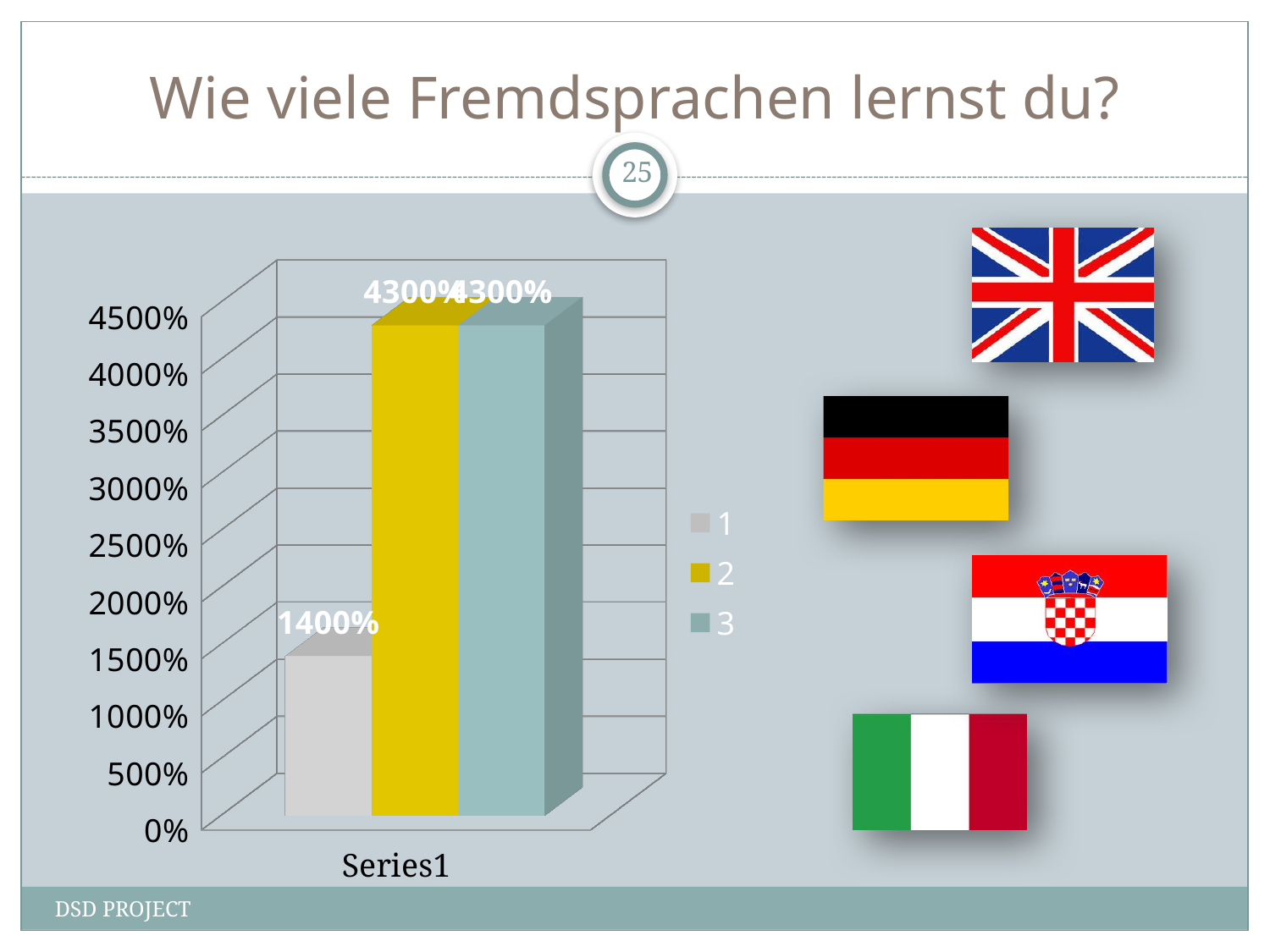
How many categories are shown on the x axis of the chart? 1 What is the value for series 1 in the bar chart? 1400% What is the value for series 2 in the bar chart? 4300% Which is larger, the value for series 1 or the value for series 2? series 2 What is the category label shown on the x axis of the chart? Series1 Which series has the lowest value in the bar chart? 1 Is the value for series 1 greater or less than 2000%? less Is the value for series 3 greater or less than 4000%? greater What kind of chart is shown on the slide? bar chart What is the difference between the values for series 2 and series 1? 2900% What is the value for series 3 in the bar chart? 4300% How many series does the legend list? 3